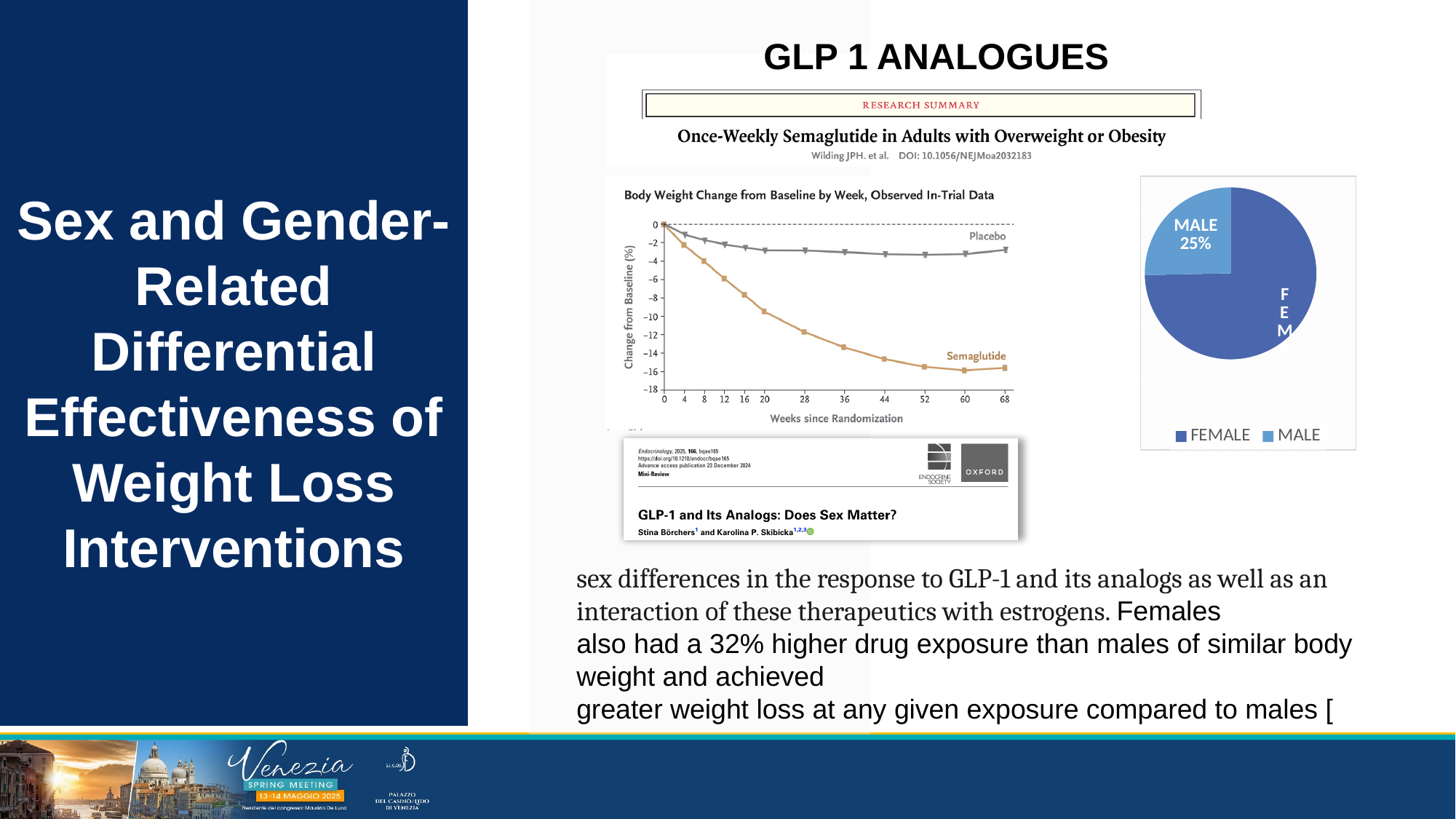
On the pie chart on the right, what share is labelled for MALE? 25% On the 'Body Weight Change from Baseline by Week' chart, what are the two series labelled? Placebo and Semaglutide On the 'Body Weight Change from Baseline by Week' chart, is the Semaglutide value at week 68 greater or less than -10? less On the 'Body Weight Change from Baseline by Week' chart, is the Placebo value at week 68 greater or less than -6? greater On the pie chart on the right, which slice is the largest? FEMALE On the 'Body Weight Change from Baseline by Week' chart, what is the label of the x axis? Weeks since Randomization On the 'Body Weight Change from Baseline by Week' chart, at week 68, which series shows the larger (less negative) change from baseline, Placebo or Semaglutide? Placebo On the pie chart on the right, what kind of chart is it? pie chart On the 'Body Weight Change from Baseline by Week' chart, does the Semaglutide line rise or fall as weeks since randomization increase? fall On the 'Body Weight Change from Baseline by Week' chart, how many series are plotted? 2 On the 'Body Weight Change from Baseline by Week' chart, what kind of chart is it? line chart On the pie chart on the right, how many entries does the legend list? 2